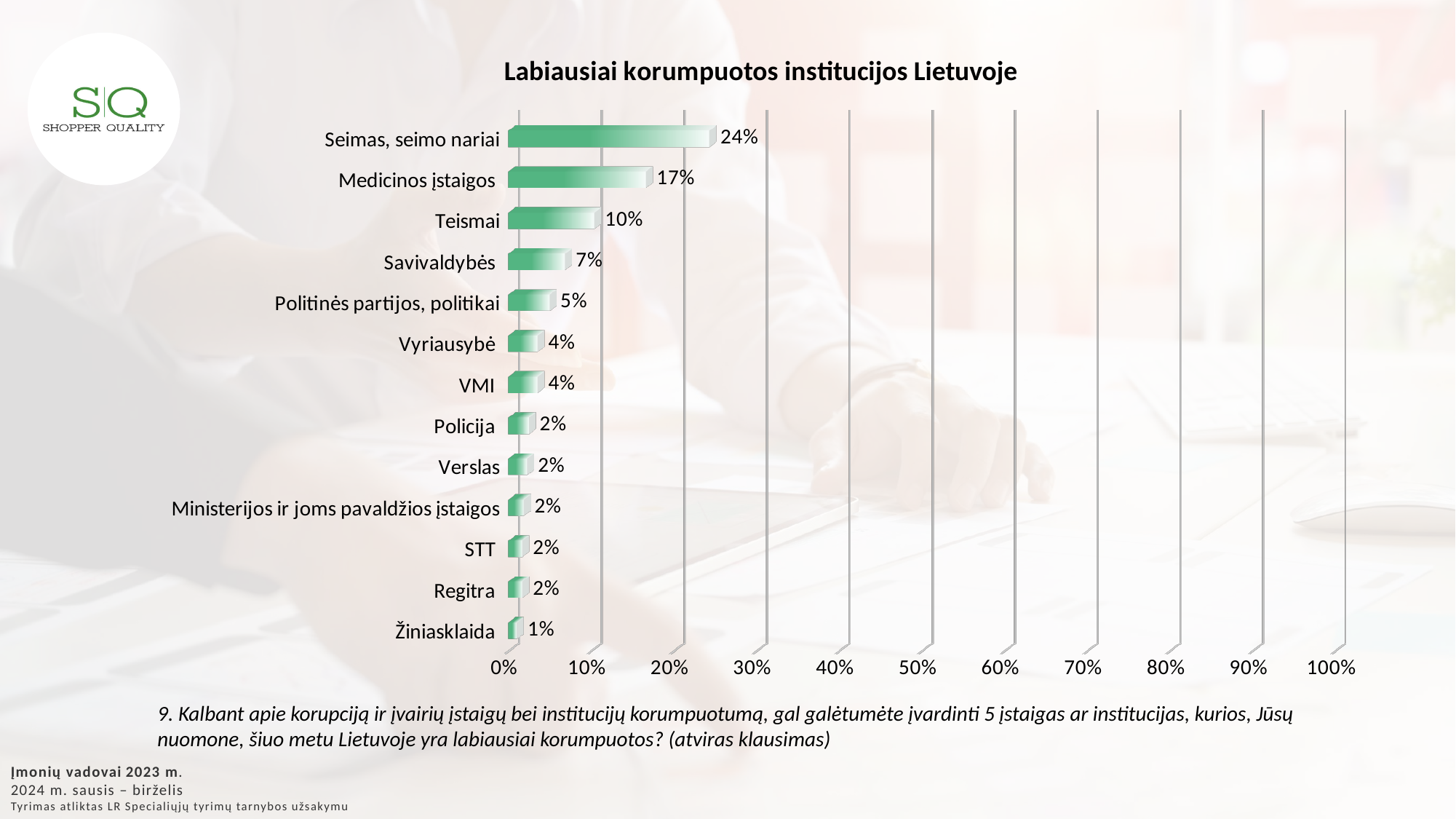
What kind of chart is shown on the slide? bar chart What is the value for Medicinos įstaigos? 17% What is the value for Seimas, seimo nariai? 24% Which category has the lowest value? Žiniasklaida Which is larger, the value for Teismai or the value for Savivaldybės? Teismai What is the difference between the values for Seimas, seimo nariai and Medicinos įstaigos? 7% How many categories are shown in the chart? 13 What is the value for Teismai? 10% Is the value for Seimas, seimo nariai greater or less than 20%? greater What is the value for Savivaldybės? 7% Which category has the highest value? Seimas, seimo nariai What is the title of the chart? Labiausiai korumpuotos institucijos Lietuvoje